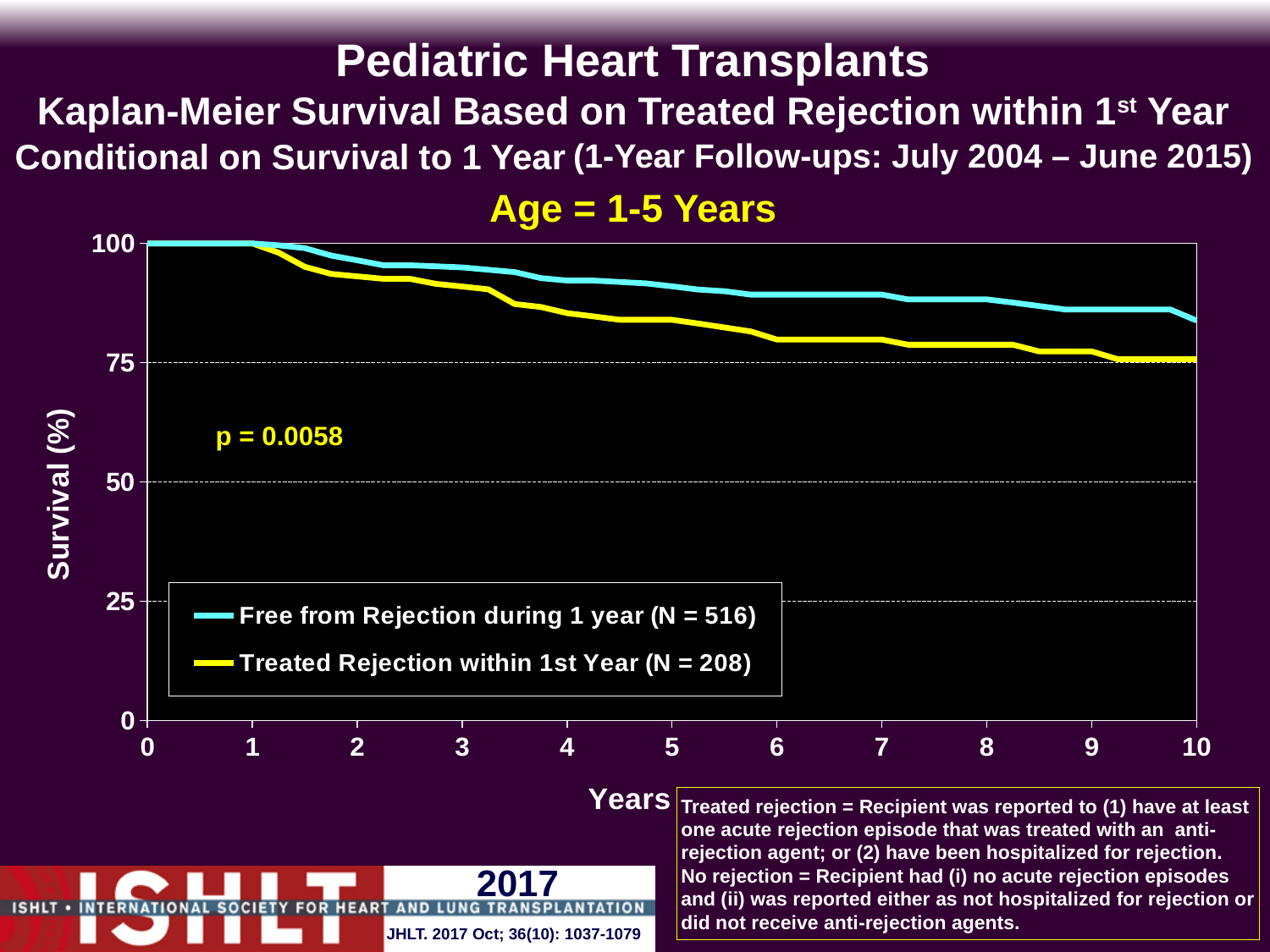
What is the N for the 'Treated Rejection within 1st Year' series? 208 What is the survival value for both series at 0 years? 100 Is the survival value for 'Treated Rejection within 1st Year' at 8 years greater or less than 100? less What kind of chart is shown on the slide? line chart What is the p-value printed on the chart? p = 0.0058 What age group does the chart cover, according to the subtitle above the plot? Age = 1-5 Years Is the survival value for 'Free from Rejection during 1 year' at 10 years greater or less than 75? greater Is the survival value for 'Treated Rejection within 1st Year' at 5 years greater or less than 75? greater What is the N for the 'Free from Rejection during 1 year' series? 516 At 10 years, which series has the higher survival: 'Free from Rejection during 1 year' or 'Treated Rejection within 1st Year'? Free from Rejection during 1 year How many series does the legend list? 2 Do the survival curves rise or fall as years increase? fall